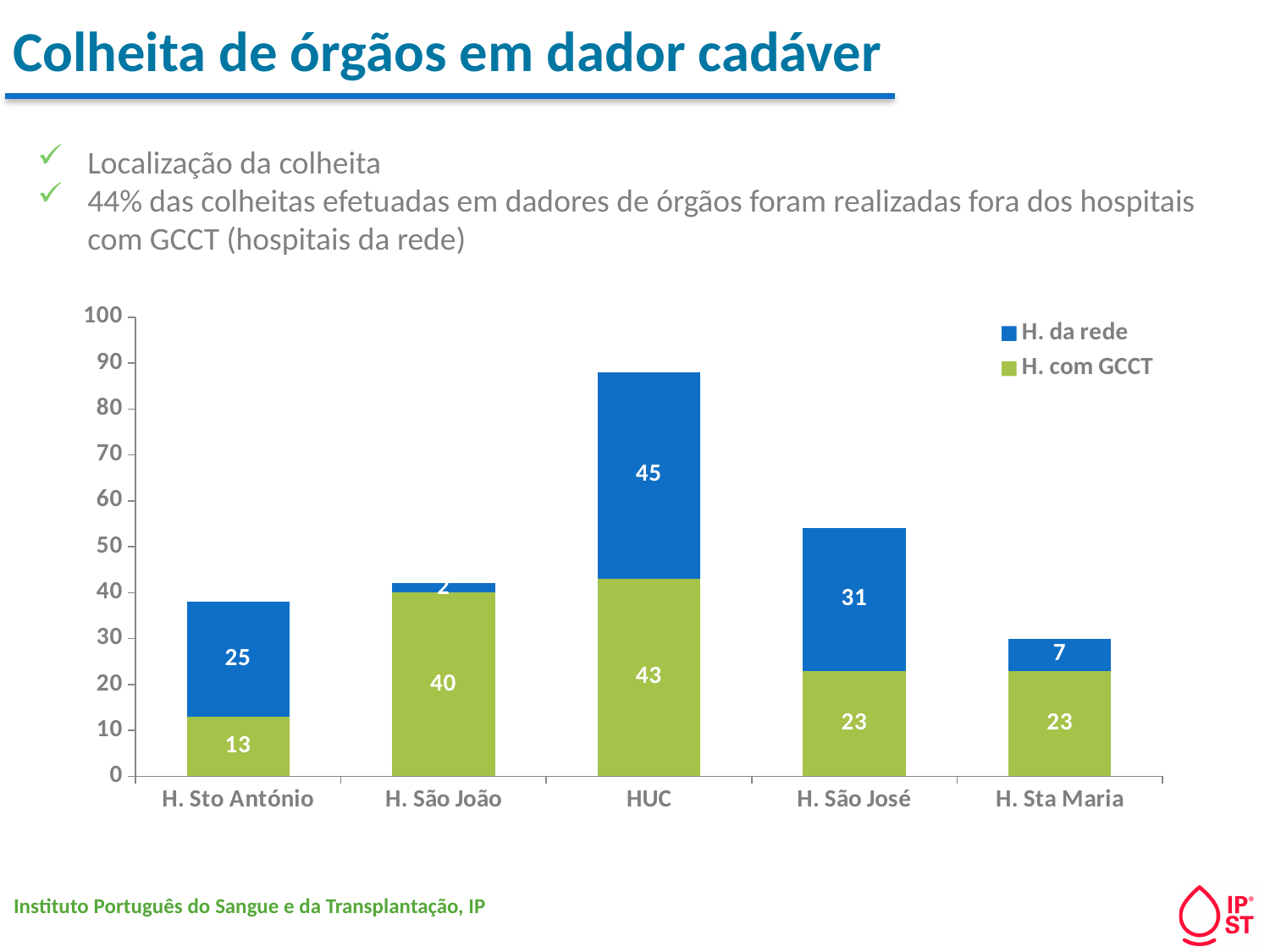
What is the value of H. com GCCT for HUC? 43 What is the value of H. com GCCT for H. Sto António? 13 What is the value of H. da rede for H. São José? 31 What is the total of the stacked bar for HUC? 88 How many series does the legend list? 2 What is the difference between the H. da rede values for H. São José and H. Sta Maria? 24 What kind of chart is shown on the slide? stacked bar chart Which series is shown in green in the legend? H. com GCCT Which hospital has the highest H. da rede value? HUC How many hospitals (categories) are shown on the x axis? 5 Which is larger: the H. com GCCT value for H. São João or for H. Sta Maria? H. São João Which hospital has the lowest H. da rede value? H. São João